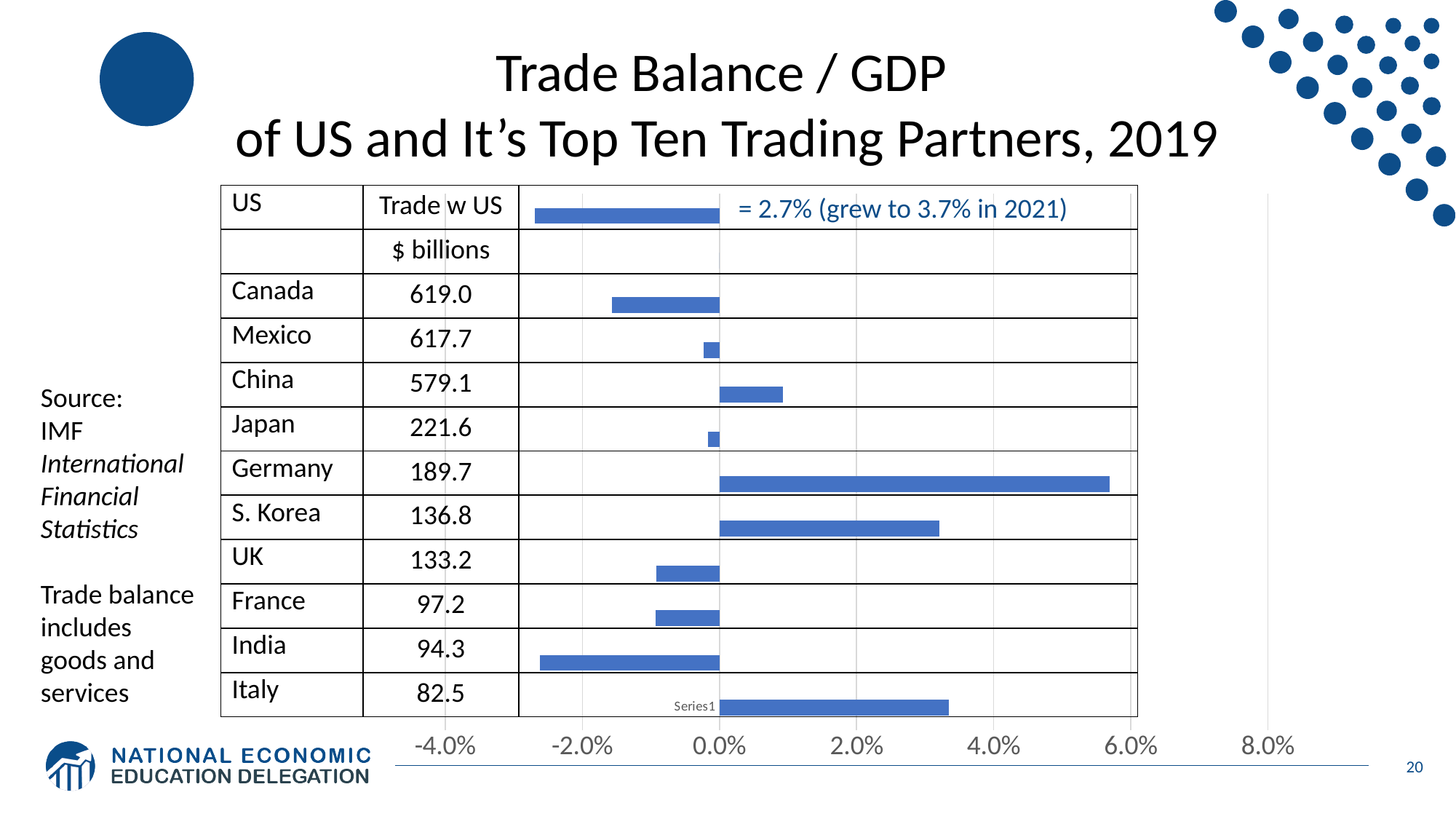
What kind of chart is shown on the slide? bar chart Which country has the highest trade balance / GDP value in the chart? Germany Which has the larger trade balance / GDP value, Canada or Mexico? Mexico According to the table, what is Canada's trade with the US in $ billions? 619.0 Is the trade balance / GDP value for China greater or less than 2.0%? less How many countries (including the US) have bars in the chart? 11 According to the annotation on the US bar, what was the US trade balance / GDP value in 2019? 2.7% Is the trade balance / GDP value for Germany greater or less than 4.0%? greater Is the trade balance / GDP value for S. Korea greater or less than 2.0%? greater Which has the larger trade balance / GDP value, Germany or S. Korea? Germany